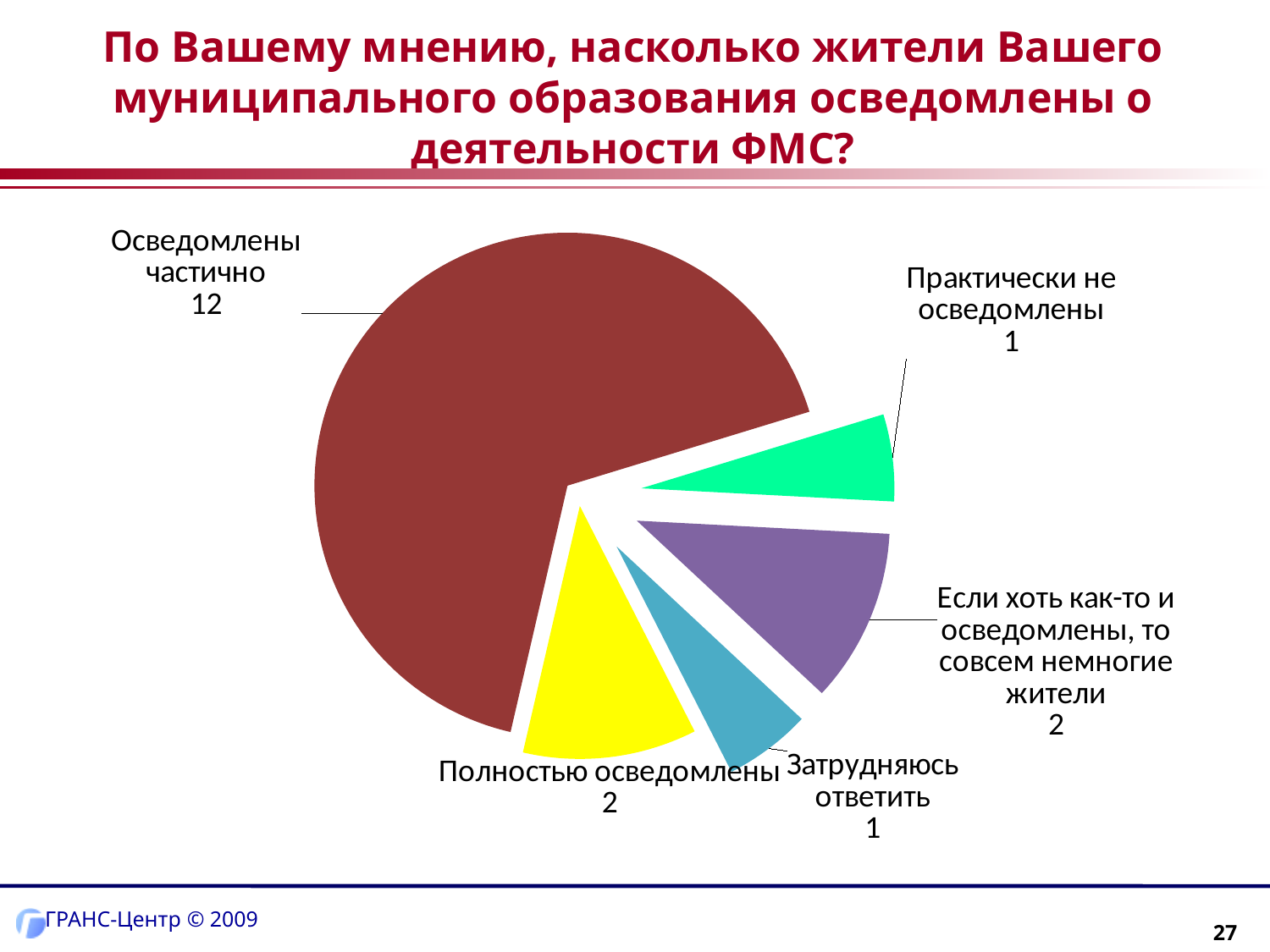
Which is larger: "Осведомлены частично" or "Полностью осведомлены"? Осведомлены частично What is the value for "Если хоть как-то и осведомлены, то совсем немногие жители"? 2 What kind of chart is shown on the slide? Pie chart What is the value for "Практически не осведомлены"? 1 What is the difference between the values for "Осведомлены частично" and "Полностью осведомлены"? 10 What is the sum of all the values shown in the pie chart? 18 What is the value for "Полностью осведомлены"? 2 What colour is the largest slice of the pie chart? Dark red What is the value for "Затрудняюсь ответить"? 1 What is the value for "Осведомлены частично"? 12 Which category has the largest slice of the pie? Осведомлены частично How many slices does the pie chart have? 5